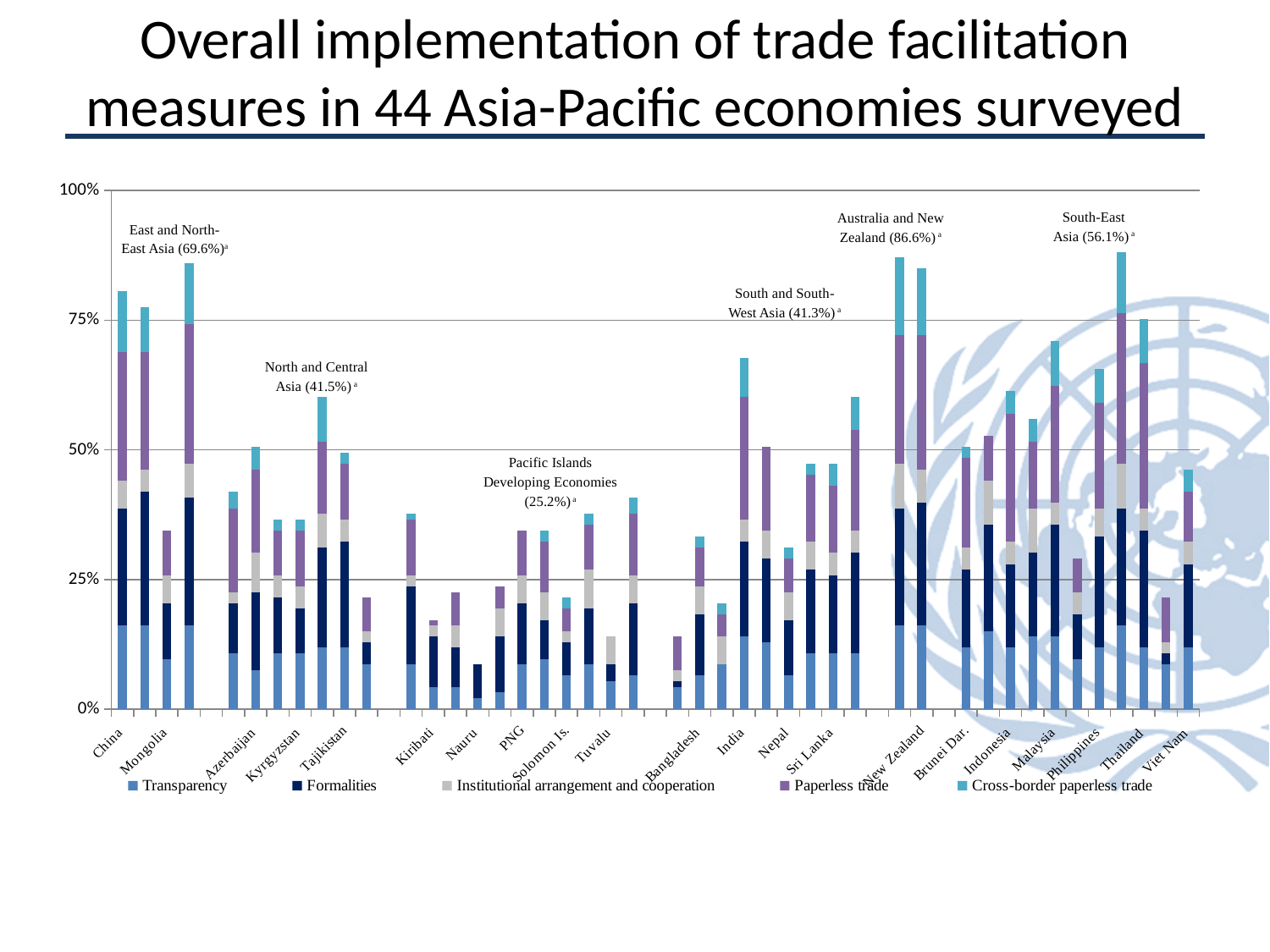
Is the total stacked value for China greater or less than 75%? greater What kind of chart is shown on the slide? Stacked bar chart Which region annotated on the chart has the highest overall implementation percentage? Australia and New Zealand How many series does the legend list? 5 According to the annotation, what is the overall implementation value for Australia and New Zealand? 86.6% Which series is listed first in the legend? Transparency Which region annotated on the chart has the lowest overall implementation percentage? Pacific Islands Developing Economies According to the annotation, what is the overall implementation value for Pacific Islands Developing Economies? 25.2% Is the total stacked value for Nauru greater or less than 25%? less According to the annotation, what is the overall implementation value for South-East Asia? 56.1% What is the difference between the annotated percentages for East and North-East Asia and South-East Asia? 13.5 percentage points Which annotated region has a higher overall implementation percentage, North and Central Asia or South and South-West Asia? North and Central Asia